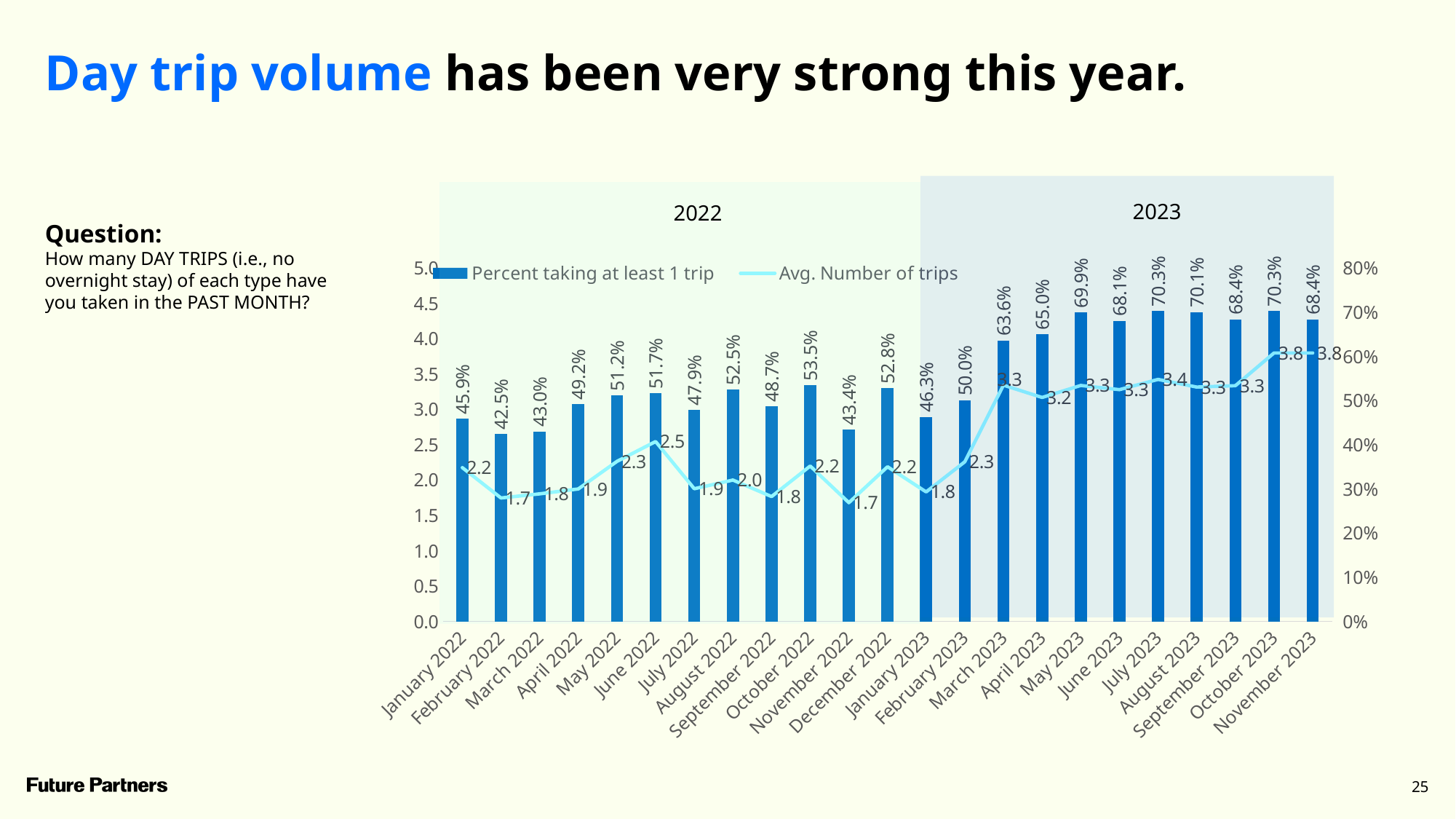
What percent of respondents took at least 1 day trip in October 2022? 53.5% What kind of chart is shown on the slide? Combined bar and line chart What was the average number of day trips in November 2023? 3.8 Which month has the lowest percent taking at least 1 trip? February 2022 What was the average number of day trips in June 2022? 2.5 Is the percent taking at least 1 trip in July 2023 greater or less than 60%? greater Does the average number of trips rise or fall from February 2023 to March 2023? rise How many months are shown on the x axis? 23 What percent of respondents took at least 1 day trip in May 2023? 69.9% What is the difference in percent taking at least 1 trip between March 2023 and February 2023? 13.6% Which is larger, the percent taking at least 1 trip in August 2022 or in September 2022? August 2022 How many series does the legend list? 2